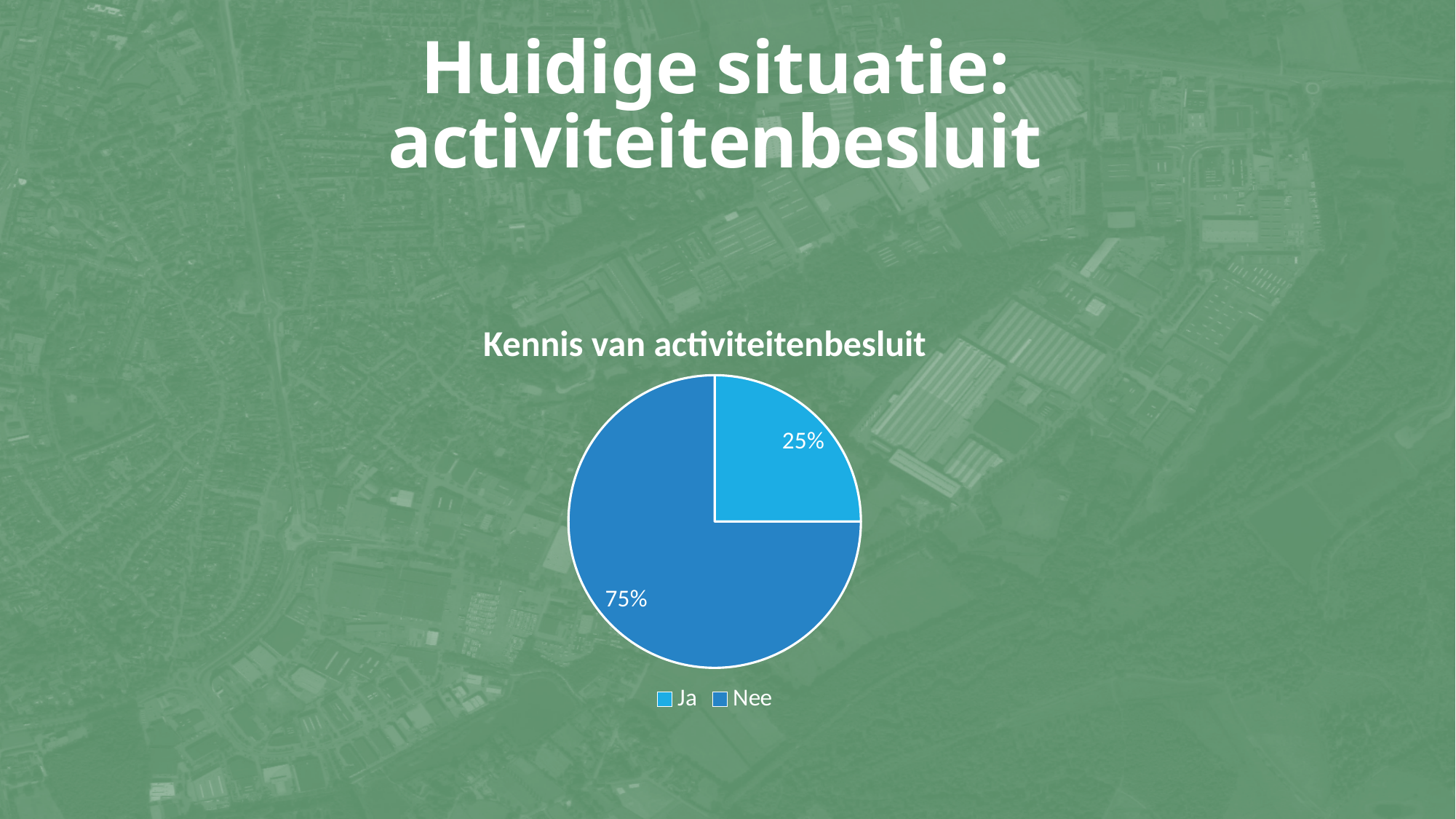
How many entries does the legend list? 2 Which category has the largest slice of the pie? Nee Which legend entry is shown in the lighter blue colour? Ja Which slice is larger, "Ja" or "Nee"? Nee What is the difference in percentage points between the "Nee" slice and the "Ja" slice? 50 What kind of chart is shown on the slide? pie chart What is the title of the chart? Kennis van activiteitenbesluit What share of the pie is labelled "Ja"? 25% How many slices does the pie chart have? 2 Is the share for "Ja" greater or less than 50%? less Which category has the smallest slice of the pie? Ja What share of the pie is labelled "Nee"? 75%